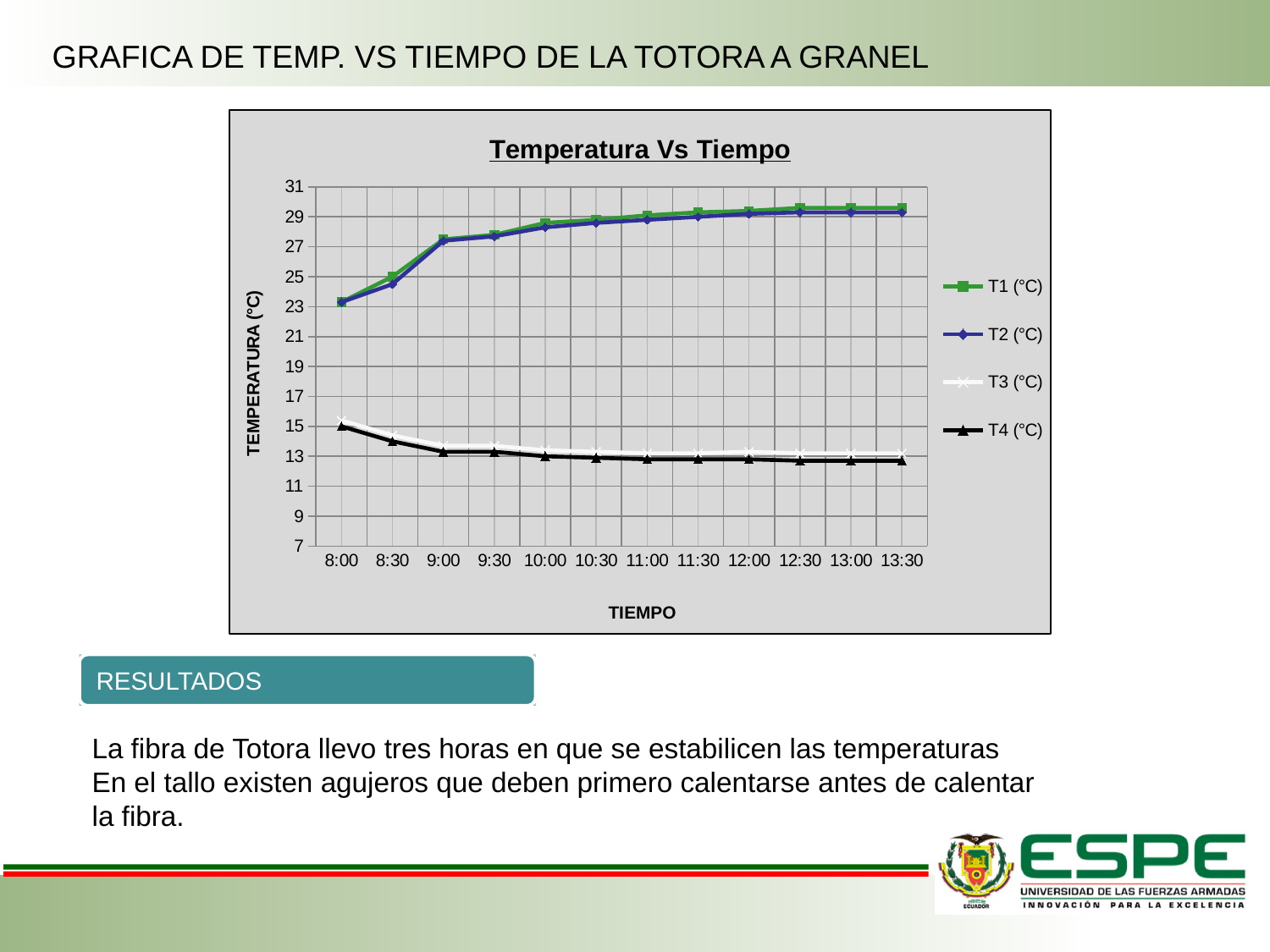
Does the T4 (°C) series rise or fall from 8:00 to 13:30? fall Does the T1 (°C) series rise or fall from 8:00 to 13:30? rise Is the value for T1 (°C) at 8:00 greater or less than 25? less At 10:00, which is larger, T1 (°C) or T3 (°C)? T1 (°C) What kind of chart is shown on the slide? line chart Is the value for T1 (°C) at 8:00 greater or less than 21? greater What is the title of the chart? Temperatura Vs Tiempo How many time points are plotted along the x axis? 12 How many series does the legend list? 4 Is the value for T4 (°C) at 13:30 greater or less than 15? less